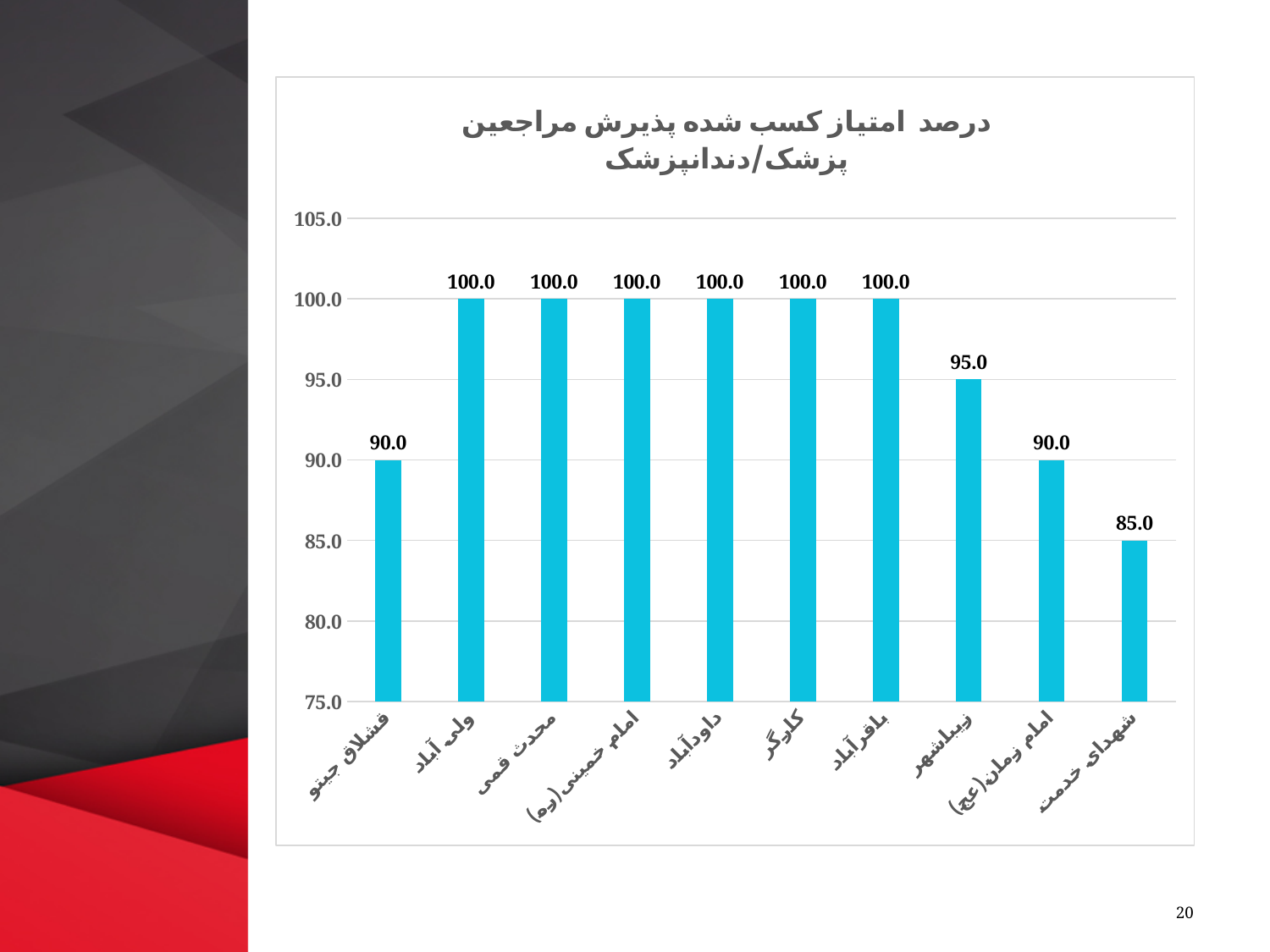
What is the value for زیباشهر? 95.0 What is the difference between the values for باقرآباد and شهدای خدمت? 15.0 Which category has the lowest value? شهدای خدمت What is the value for قشلاق جیتو? 90.0 What is the difference between the values for زیباشهر and امام زمان(عج)? 5.0 Across the last three categories, from زیباشهر to شهدای خدمت, do the values rise or fall? fall What is the value for کارگر? 100.0 How many categories are shown on the x axis? 10 What is the value for شهدای خدمت? 85.0 Which is larger, the value for زیباشهر or the value for امام زمان(عج)? زیباشهر What kind of chart is this? bar chart Is the value for قشلاق جیتو greater or less than 95? less